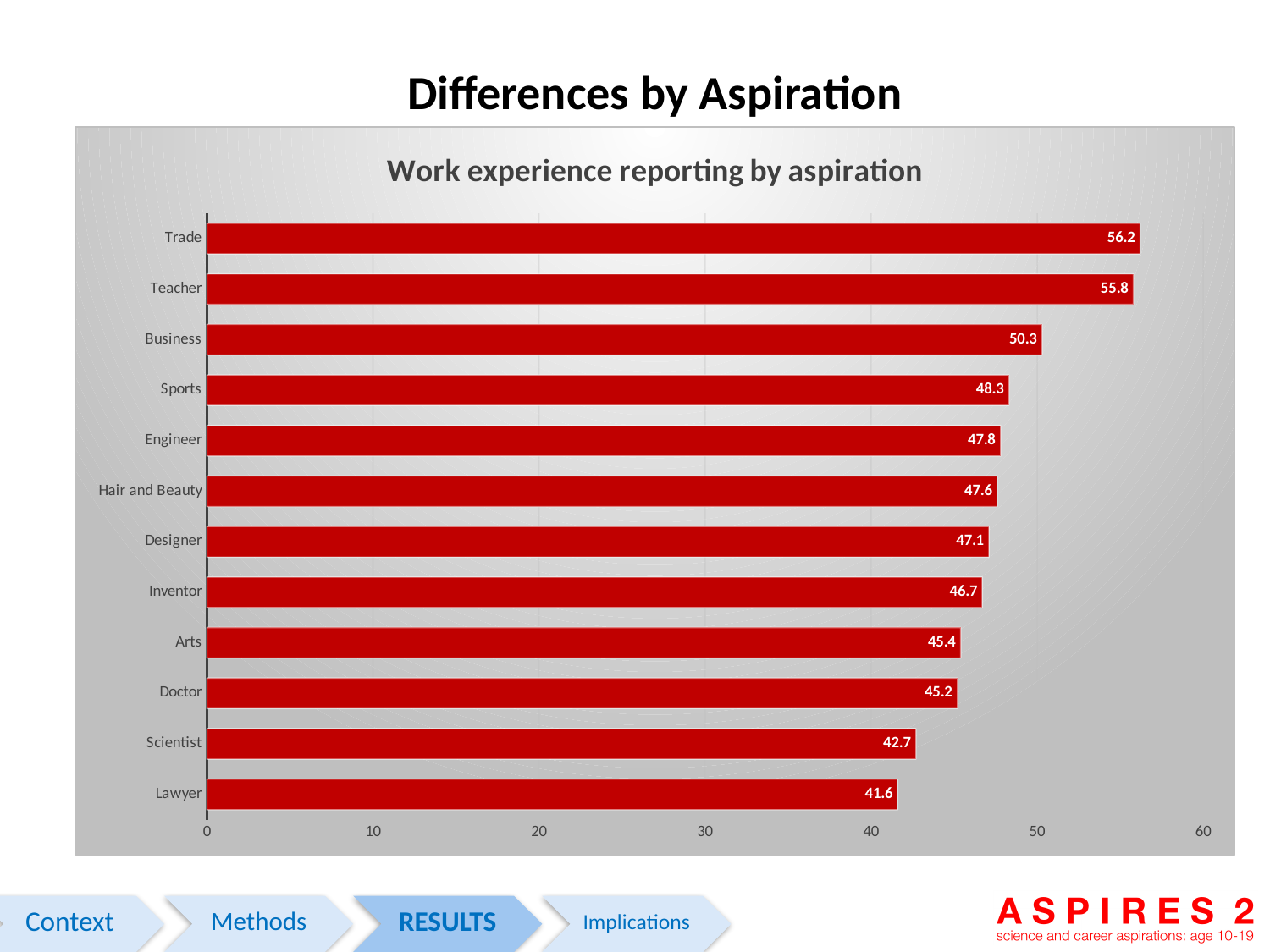
What is the difference between the values for Trade and Lawyer? 14.6 Which aspiration has the lowest value? Lawyer Is the value for Business greater or less than 50? greater Which aspiration has the highest value? Trade What is the value for Scientist? 42.7 What is the value for Trade? 56.2 What is the title of the chart? Work experience reporting by aspiration What is the difference between the values for Business and Sports? 2.0 Which is larger, the value for Engineer or the value for Doctor? Engineer What kind of chart is shown on the slide? Bar chart How many aspiration categories are shown in the chart? 12 What is the value for Hair and Beauty? 47.6